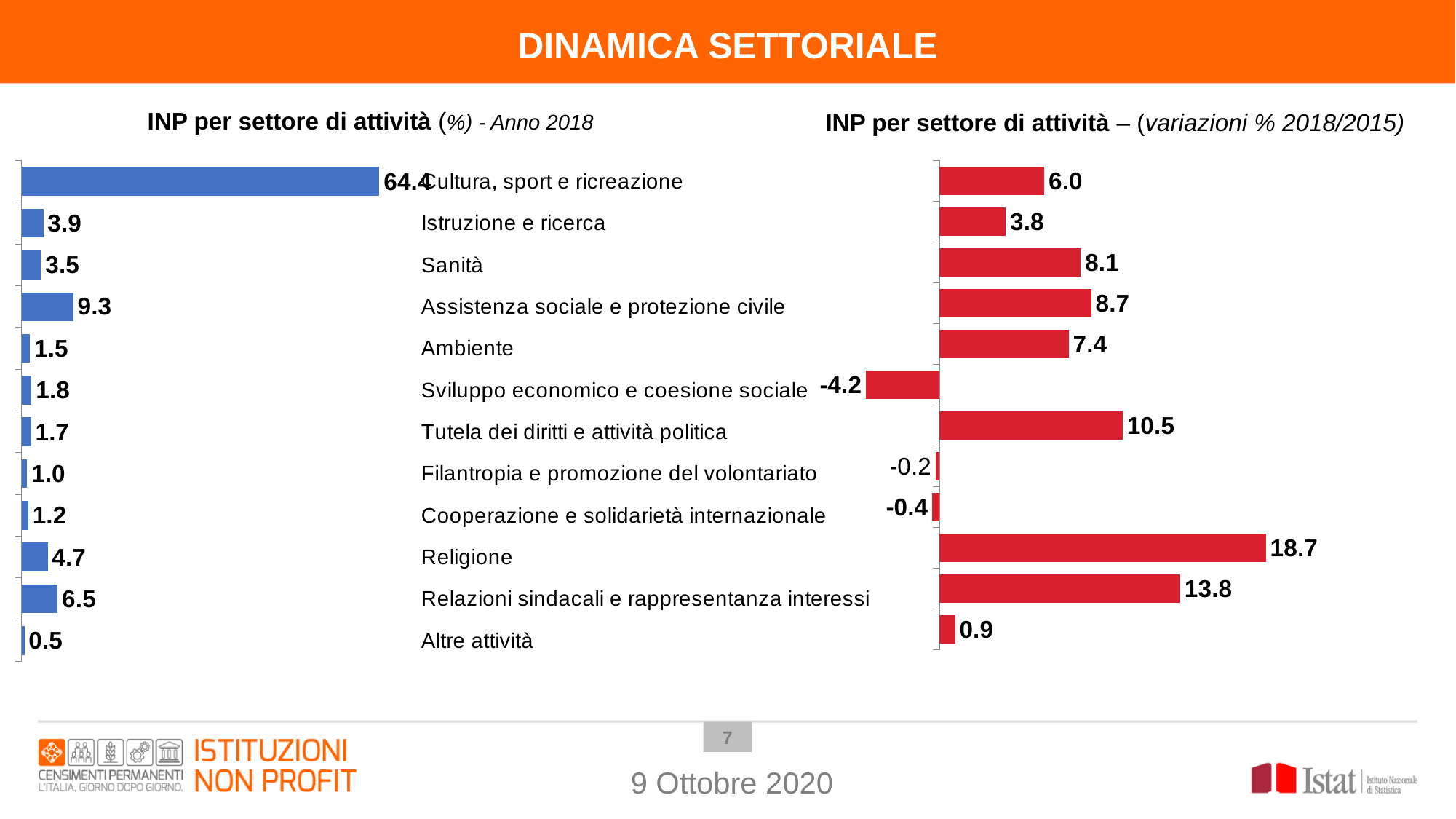
In the right chart (variazioni % 2018/2015), which category has the lowest value? Sviluppo economico e coesione sociale In the left chart (Anno 2018), which category has the lowest value? Altre attività In the right chart (variazioni % 2018/2015), what is the value for Sviluppo economico e coesione sociale? -4.2 In the right chart (variazioni % 2018/2015), what is the value for Religione? 18.7 In the left chart (Anno 2018), what is the value for Assistenza sociale e protezione civile? 9.3 In the left chart (INP per settore di attività (%) - Anno 2018), what is the value for Cultura, sport e ricreazione? 64.4 How many categories are shown in the left chart (Anno 2018)? 12 In the right chart (variazioni % 2018/2015), how many categories have a negative value? 3 In the left chart (Anno 2018), what is the difference between the values for Relazioni sindacali e rappresentanza interessi and Religione? 1.8 In the right chart (variazioni % 2018/2015), which is larger: the value for Tutela dei diritti e attività politica or the value for Sanità? Tutela dei diritti e attività politica What type of chart is the right chart (variazioni % 2018/2015)? Bar chart In the right chart (variazioni % 2018/2015), which category has the highest value? Religione